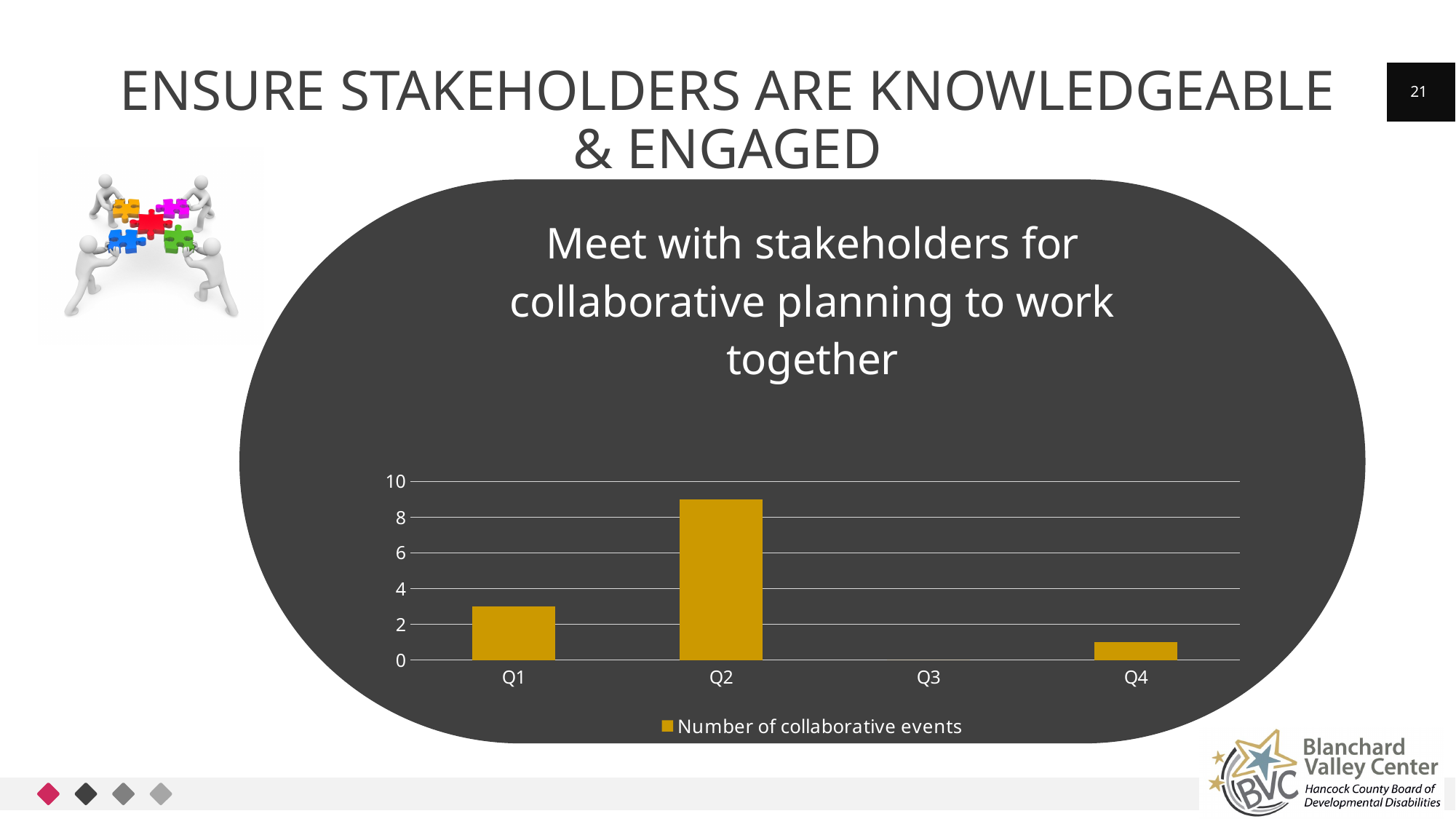
Which quarter has the lowest number of collaborative events? Q3 Is the value for Q4 greater or less than 2? less Is the value for Q2 greater or less than 8? greater What is the title of the chart? Meet with stakeholders for collaborative planning to work together How many quarters are shown on the x axis of the chart? 4 How many series does the chart legend list? 1 Which has more collaborative events, Q1 or Q4? Q1 What series name is shown in the chart legend? Number of collaborative events Which quarter has the highest number of collaborative events? Q2 What kind of chart is shown on the slide? bar chart Is the value for Q1 greater or less than 2? greater